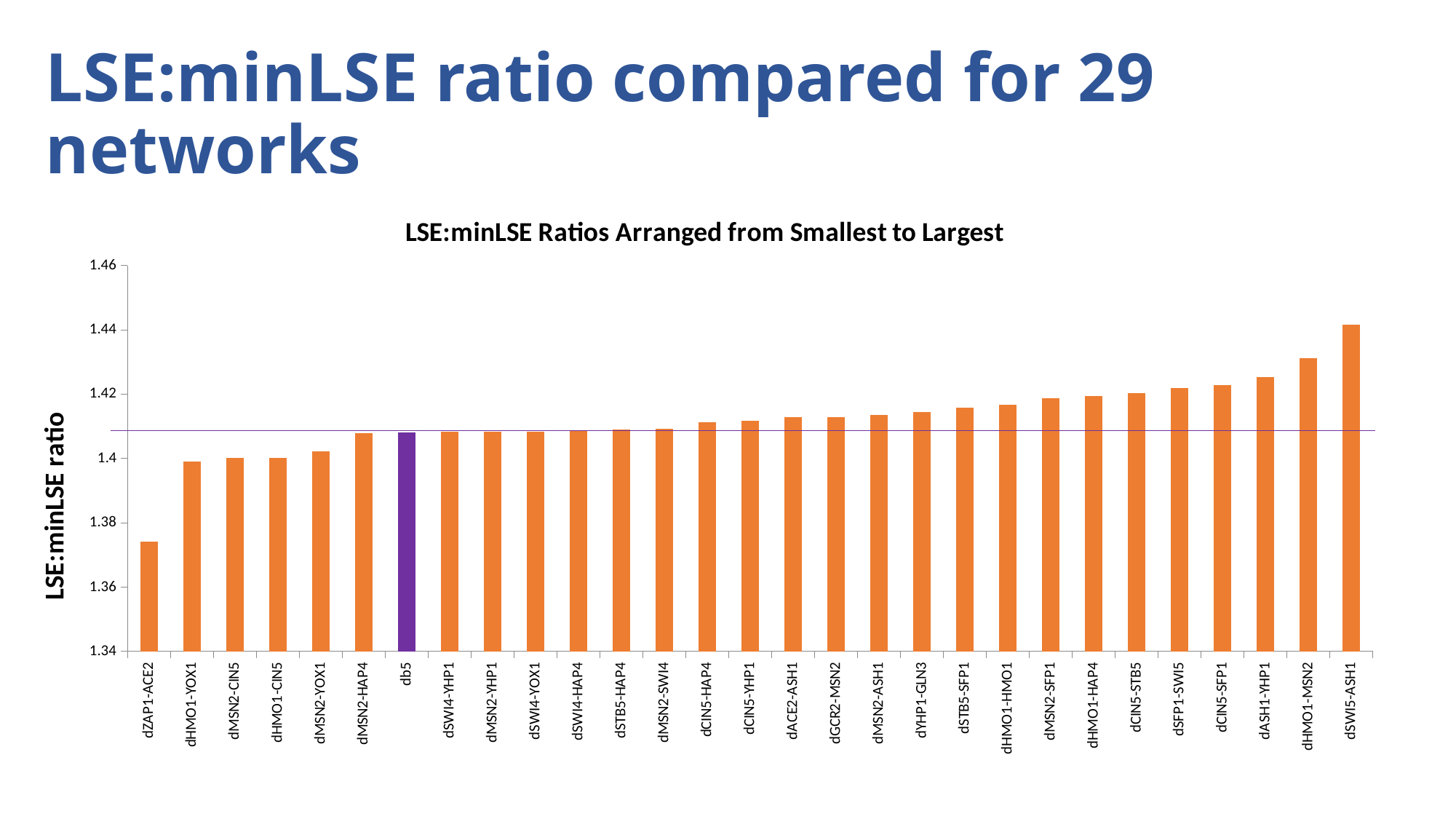
Which has the larger LSE:minLSE ratio, dZAP1-ACE2 or dHMO1-YOX1? dHMO1-YOX1 Which network has the highest LSE:minLSE ratio? dSWI5-ASH1 Which network's bar is coloured purple instead of orange? db5 Is the value for dASH1-YHP1 greater or less than 1.42? greater Is the value for dZAP1-ACE2 greater or less than 1.38? less Do the bar values rise or fall from left to right along the x axis? rise Which has the larger LSE:minLSE ratio, dHMO1-MSN2 or dASH1-YHP1? dHMO1-MSN2 What kind of chart is shown on the slide? bar chart Is the value for dMSN2-HAP4 greater or less than 1.40? greater How many networks (bars) are plotted in the chart? 29 Which network has the lowest LSE:minLSE ratio? dZAP1-ACE2